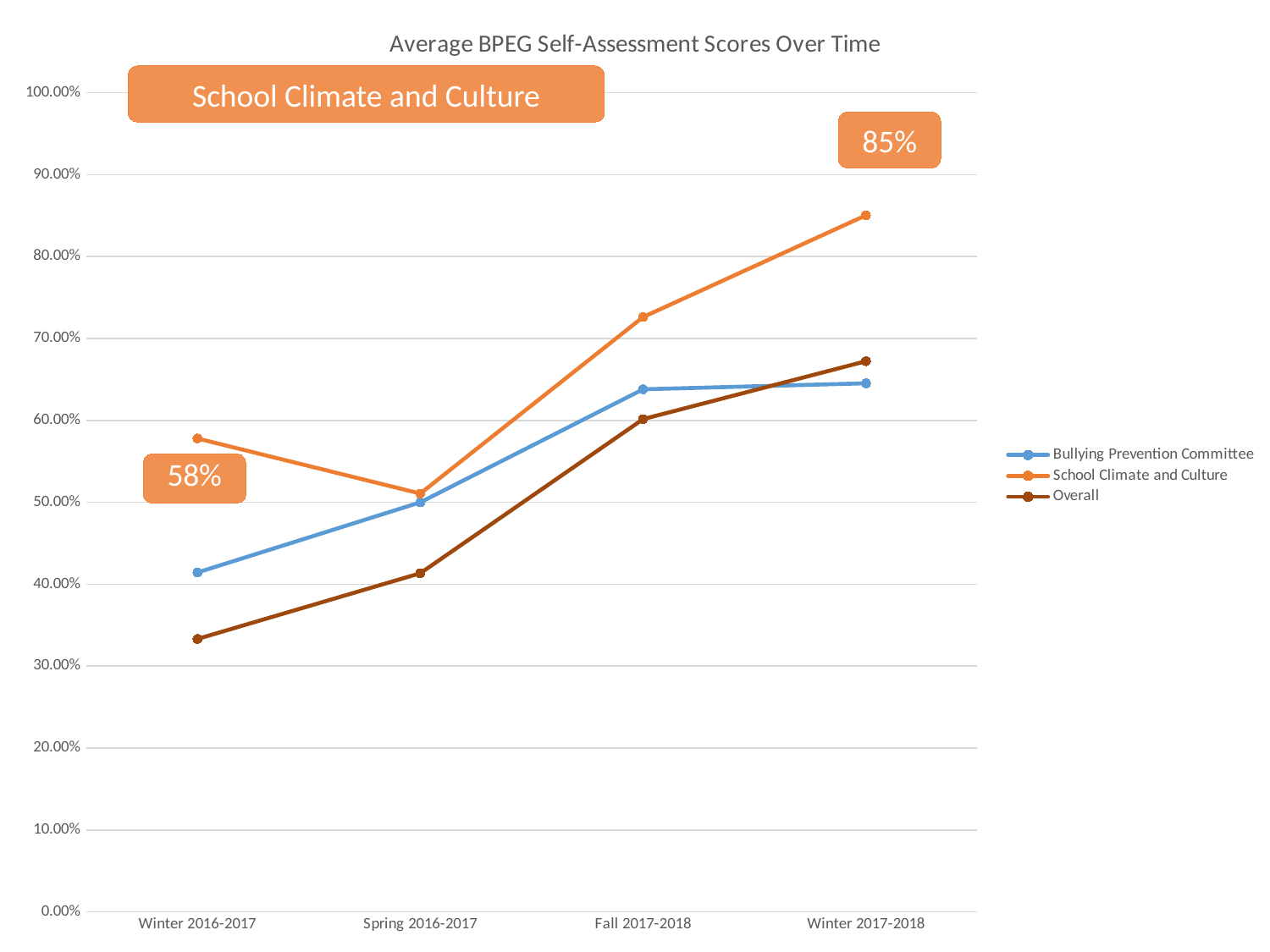
Is the Overall value for Winter 2016-2017 greater or less than 40%? less At which time period is the School Climate and Culture series at its lowest? Spring 2016-2017 According to the callout on the slide, what was the School Climate and Culture score in Winter 2017-2018? 85% What kind of chart is shown on the slide? line chart Which series has the lowest value in Winter 2016-2017? Overall Is the Bullying Prevention Committee value for Fall 2017-2018 greater or less than 60%? greater According to the callout on the slide, what was the School Climate and Culture score in Winter 2016-2017? 58% What is the title of the chart? Average BPEG Self-Assessment Scores Over Time How many time periods are shown on the x axis? 4 How many series does the legend list? 3 Which series has the highest value in Winter 2017-2018? School Climate and Culture Does the Overall series rise or fall from Winter 2016-2017 to Winter 2017-2018? rise